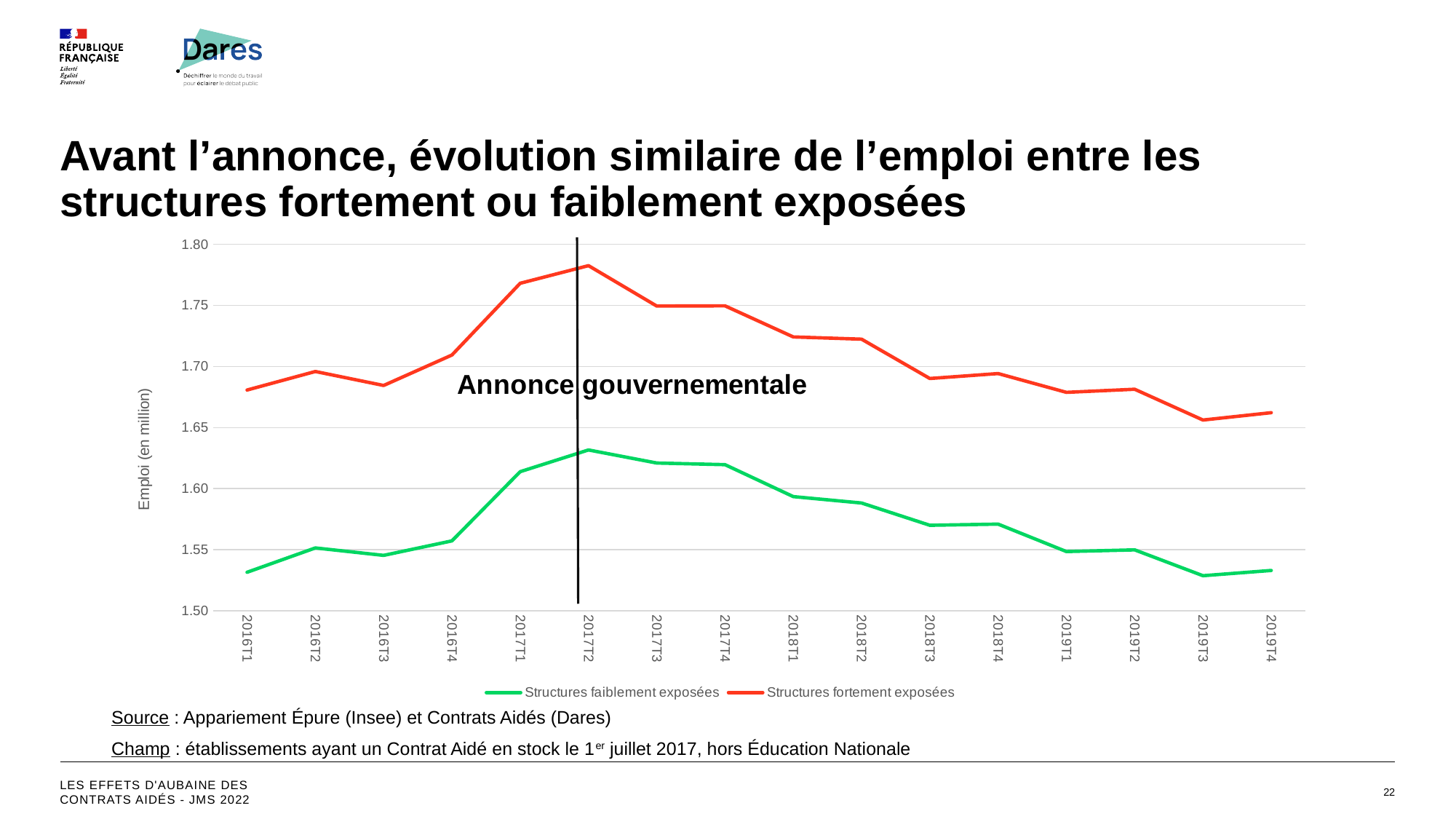
Is the value for 'Structures faiblement exposées' in 2017T2 greater or less than 1.60? greater How many series does the legend list? 2 Is the value for 'Structures fortement exposées' in 2016T1 greater or less than 1.70? less What label is shown on the y axis of the chart? Emploi (en million) Which series has the higher value in 2018T1, 'Structures faiblement exposées' or 'Structures fortement exposées'? Structures fortement exposées Is the value for 'Structures fortement exposées' in 2017T2 greater or less than 1.75? greater Do the values for 'Structures fortement exposées' rise or fall between 2017T2 and 2019T4? Fall How many quarters are plotted along the x axis? 16 In which quarter does the series 'Structures fortement exposées' reach its highest value? 2017T2 What kind of chart is shown on the slide? Line chart In which quarter does the series 'Structures faiblement exposées' reach its highest value? 2017T2